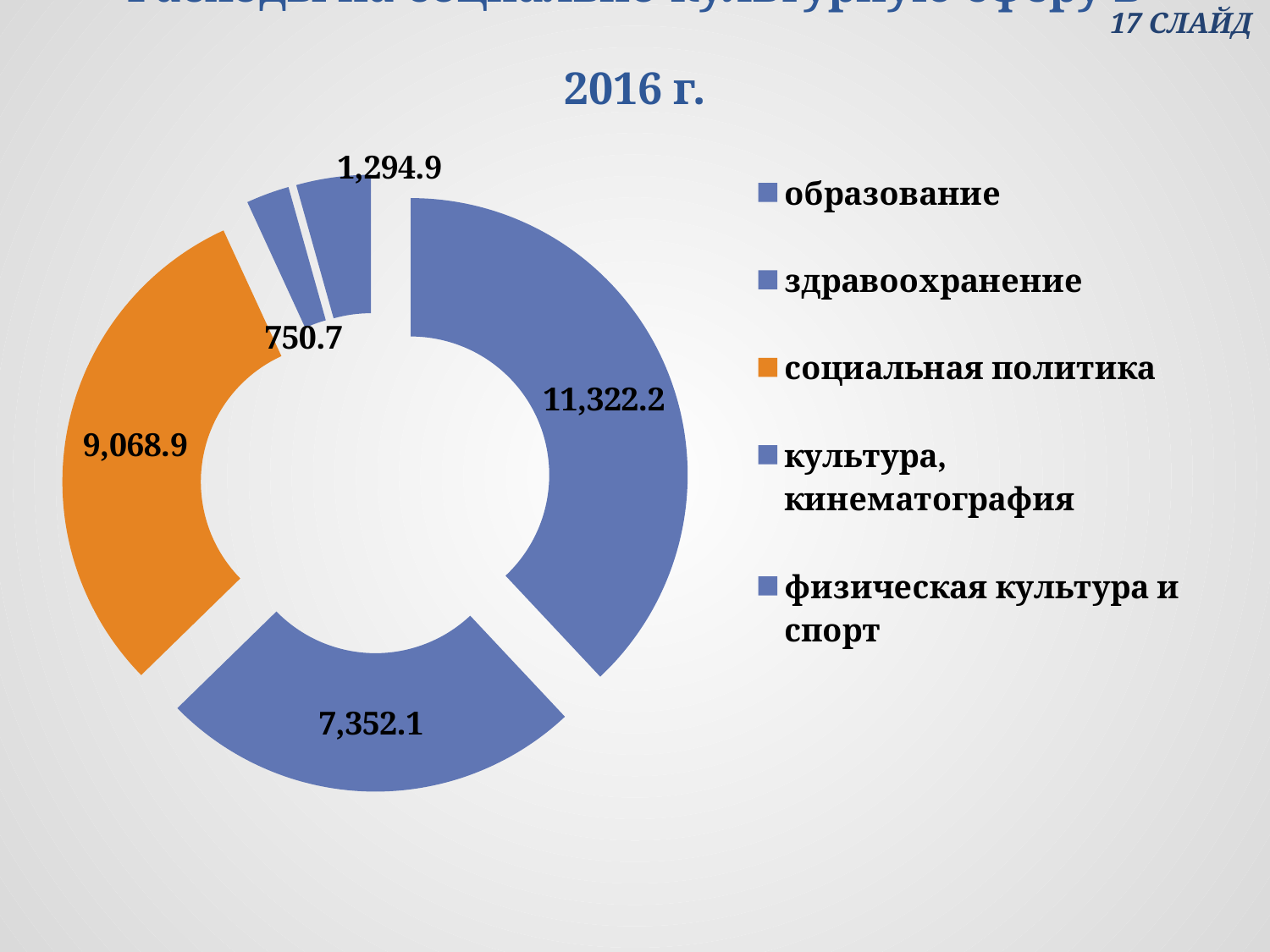
What is the value of the orange slice (социальная политика)? 9,068.9 Which category has the largest slice? образование How many categories does the legend list? 5 What is the difference between the largest slice (11,322.2) and the orange slice (9,068.9)? 2,253.3 Which category has the smallest slice? культура, кинематография What is the difference between the two smallest slices, 1,294.9 and 750.7? 544.2 What is the largest value shown on the chart? 11,322.2 What is the total of all slice values on the chart? 29,788.8 What is the smallest value shown on the chart? 750.7 Which is larger: the slice labelled 9,068.9 or the slice labelled 7,352.1? 9,068.9 Which legend entry is shown in orange? социальная политика What kind of chart is shown on the slide? doughnut (pie) chart